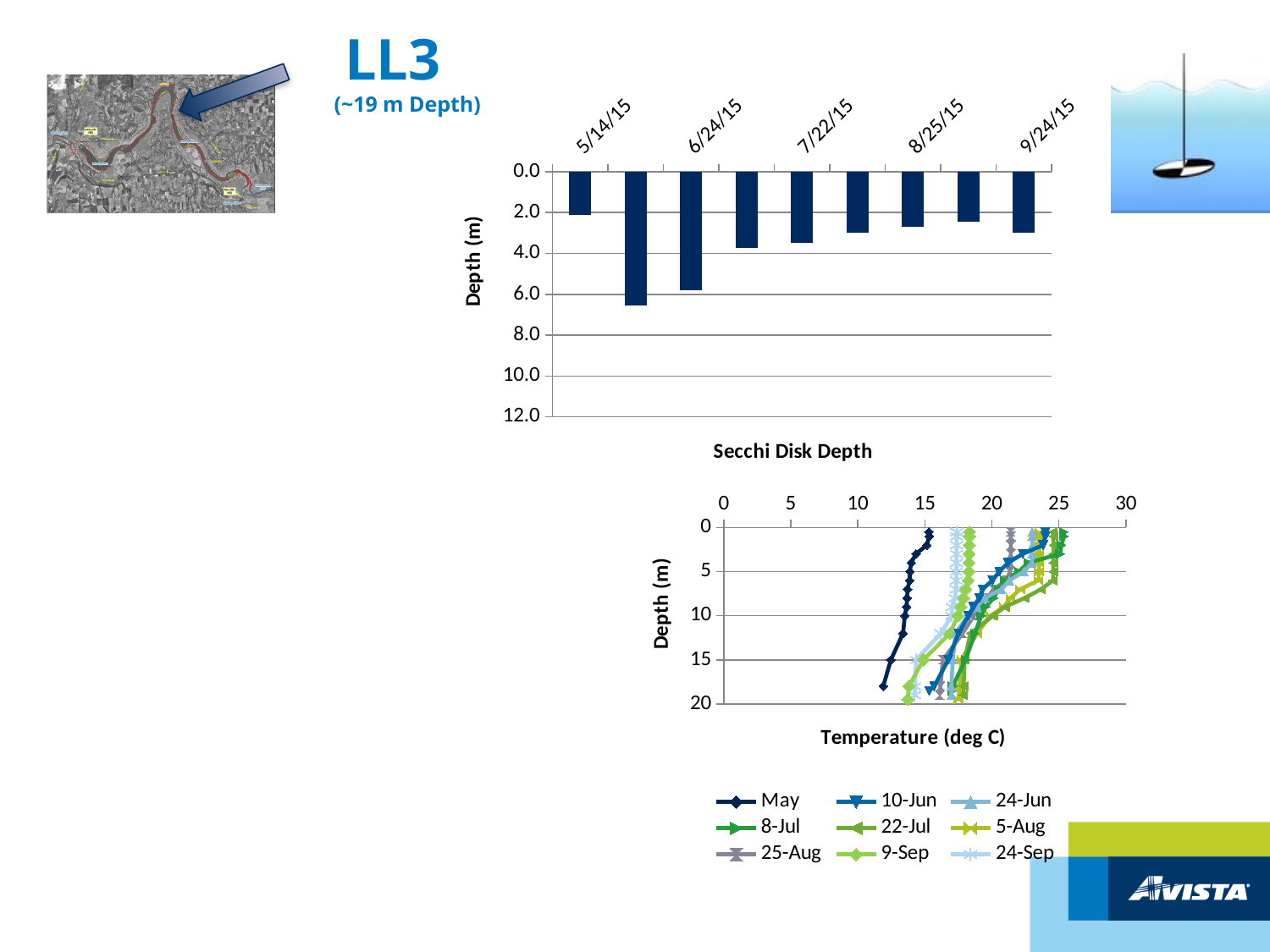
What kind of chart is the Temperature (deg C) chart? line chart In the Secchi Disk Depth chart, which has the deeper Secchi depth, 6/24/15 or 7/22/15? 6/24/15 How many series does the legend of the Temperature (deg C) chart list? 9 How many bars are plotted in the Secchi Disk Depth chart? 9 In the Secchi Disk Depth chart, is the depth for 6/24/15 greater or less than 4.0 m? greater What kind of chart is the Secchi Disk Depth chart? bar chart In the Secchi Disk Depth chart, is the depth for 5/14/15 greater or less than 4.0 m? less In the Temperature (deg C) chart, does temperature generally rise or fall as depth increases? fall In the Secchi Disk Depth chart, is the depth for 9/24/15 greater or less than 4.0 m? less What is the y-axis title of the Temperature (deg C) chart? Depth (m)